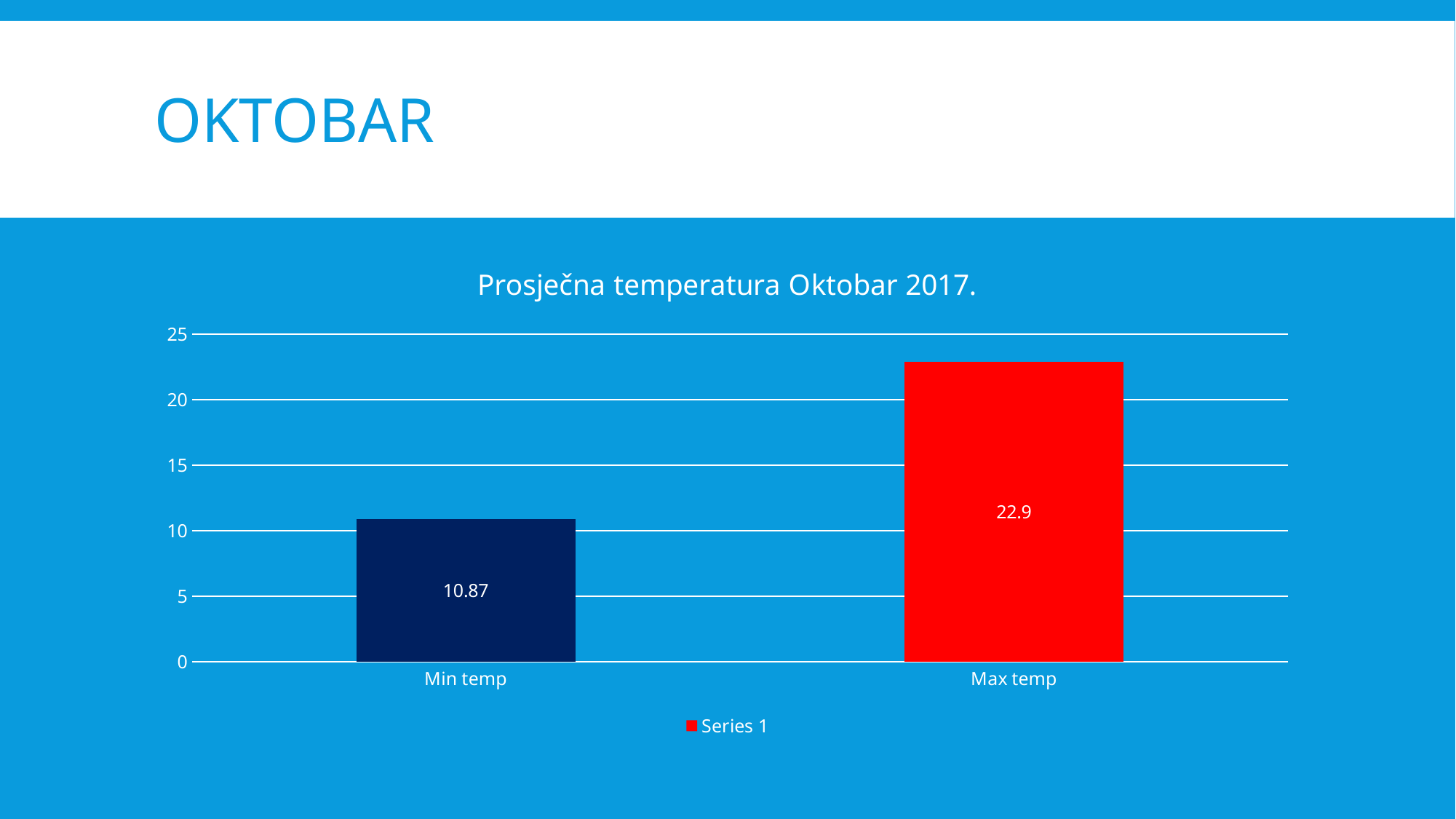
What kind of chart is shown? bar chart Which is larger, the value for Min temp or the value for Max temp? Max temp What is the value for Max temp? 22.9 Which category has the lowest value? Min temp Which category has the highest value? Max temp How many series does the legend list? 1 Is the value for Max temp greater or less than 20? greater What is the value for Min temp? 10.87 Is the value for Min temp greater or less than 15? less What is the title of the chart? Prosječna temperatura Oktobar 2017. How many categories are shown on the x axis? 2 What is the difference between the Max temp and Min temp values? 12.03